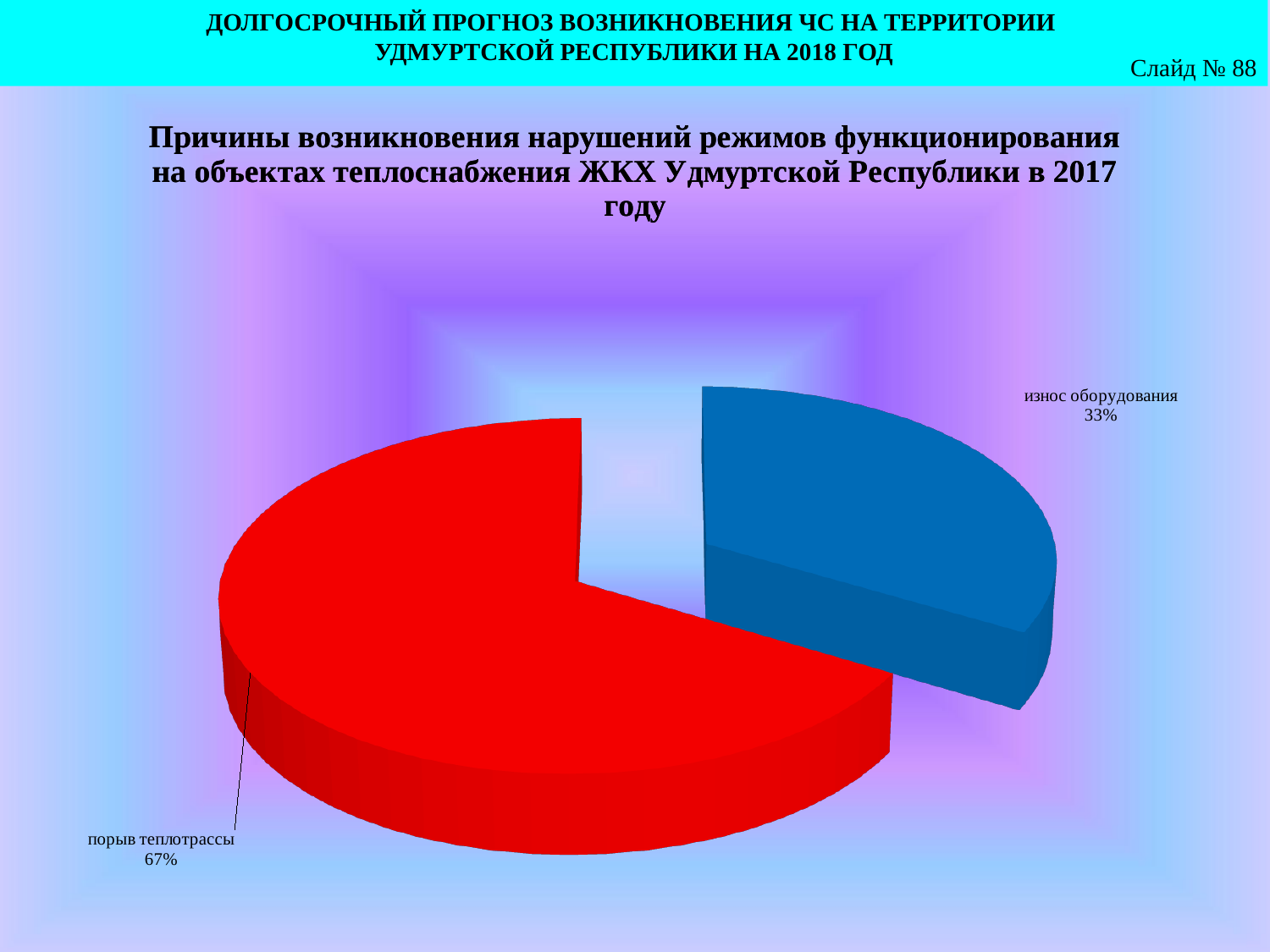
Is the share for "порыв теплотрассы" greater or less than 50%? greater Which category has the largest slice of the pie? порыв теплотрассы Which category has the smallest slice of the pie? износ оборудования What is the difference in percentage points between the share for "порыв теплотрассы" and the share for "износ оборудования"? 34 How many categories (slices) does the pie chart show? 2 Which is larger: the share for "износ оборудования" or the share for "порыв теплотрассы"? порыв теплотрассы What colour is the slice for "износ оборудования"? blue What kind of chart is shown on the slide? pie chart What is the total of the two slice percentages shown on the pie chart? 100% What colour is the slice for "порыв теплотрассы"? red What share of the pie does "порыв теплотрассы" account for? 67% What share of the pie does "износ оборудования" account for? 33%